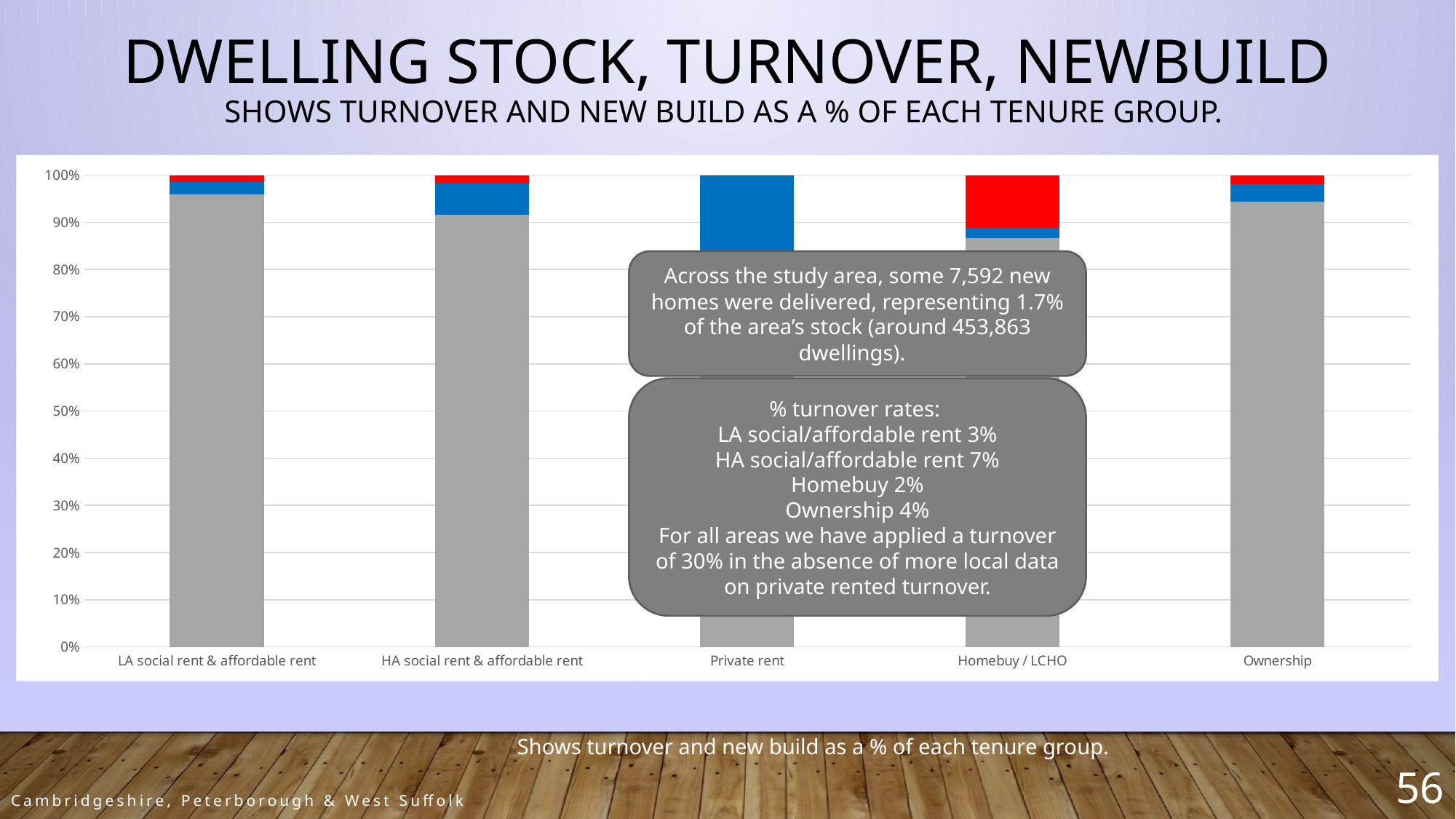
Is the grey segment for Ownership greater or less than 90%? greater What is the main title of the slide containing the chart? Dwelling stock, turnover, newbuild Which tenure group has the largest blue segment in the chart? Private rent Is the grey segment for LA social rent & affordable rent greater or less than 90%? greater Which has the larger grey segment: HA social rent & affordable rent or Homebuy / LCHO? HA social rent & affordable rent What is the highest value shown on the chart's y axis? 100% Which tenure group has the largest red segment in the chart? Homebuy / LCHO Is the grey segment for Homebuy / LCHO greater or less than 90%? less How many tenure groups are shown along the x axis of the chart? 5 What kind of chart is shown on the slide? Stacked bar chart Which has the larger red segment: Homebuy / LCHO or LA social rent & affordable rent? Homebuy / LCHO